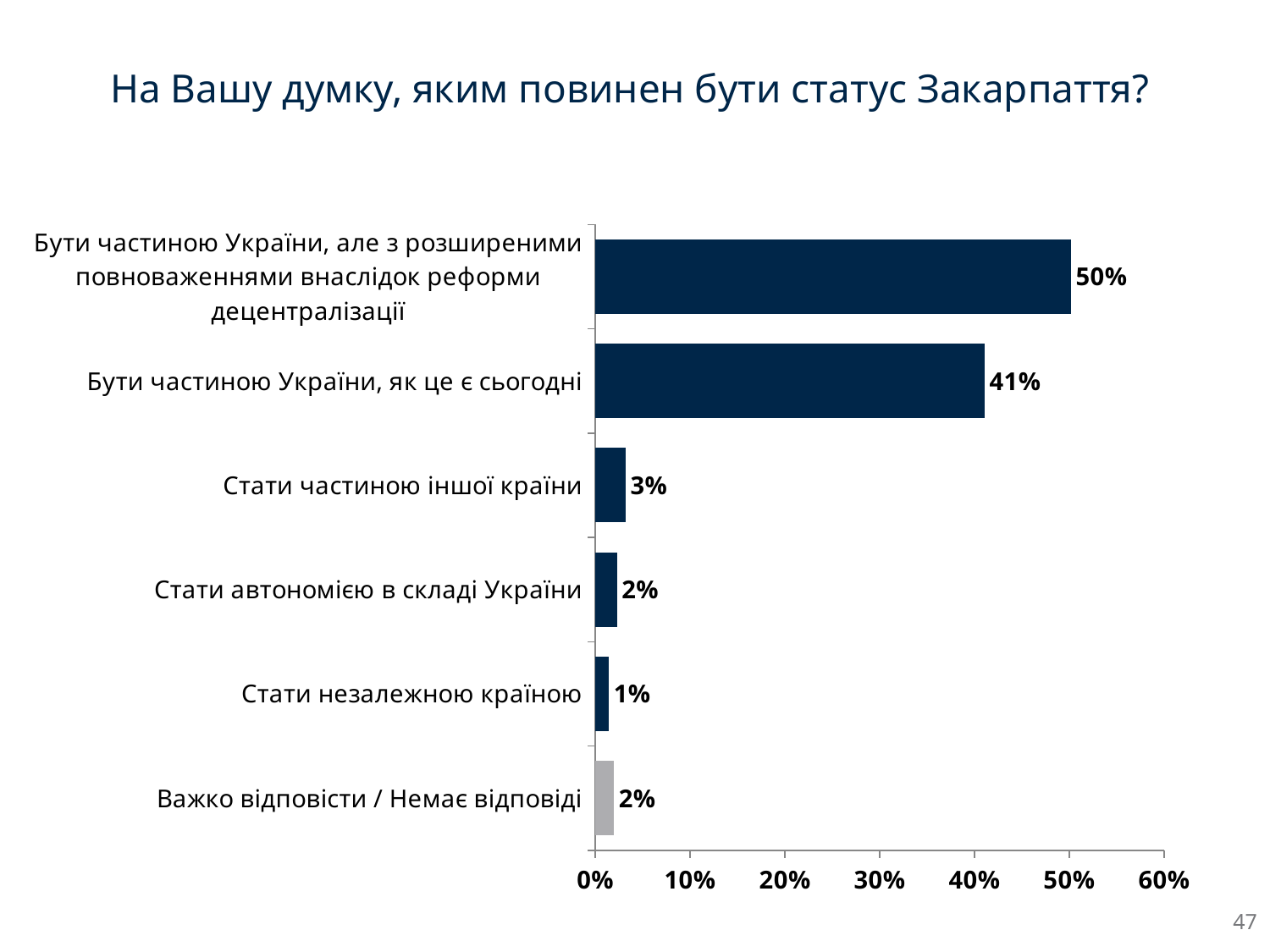
What is the value for "Бути частиною України, як це є сьогодні"? 41% Is the value for "Бути частиною України, як це є сьогодні" greater or less than 30%? greater What is the difference between the values for "Бути частиною України, але з розширеними повноваженнями внаслідок реформи децентралізації" and "Бути частиною України, як це є сьогодні"? 9% What is the value for "Стати незалежною країною"? 1% How many categories are shown in the chart? 6 What is the title of the chart? На Вашу думку, яким повинен бути статус Закарпаття? What percentage of respondents chose "Бути частиною України, але з розширеними повноваженнями внаслідок реформи децентралізації"? 50% Which category has the lowest value? Стати незалежною країною Which category has the highest value? Бути частиною України, але з розширеними повноваженнями внаслідок реформи децентралізації Which is larger: the value for "Стати частиною іншої країни" or for "Стати автономією в складі України"? Стати частиною іншої країни What is the value for "Стати частиною іншої країни"? 3% What kind of chart is shown on the slide? bar chart